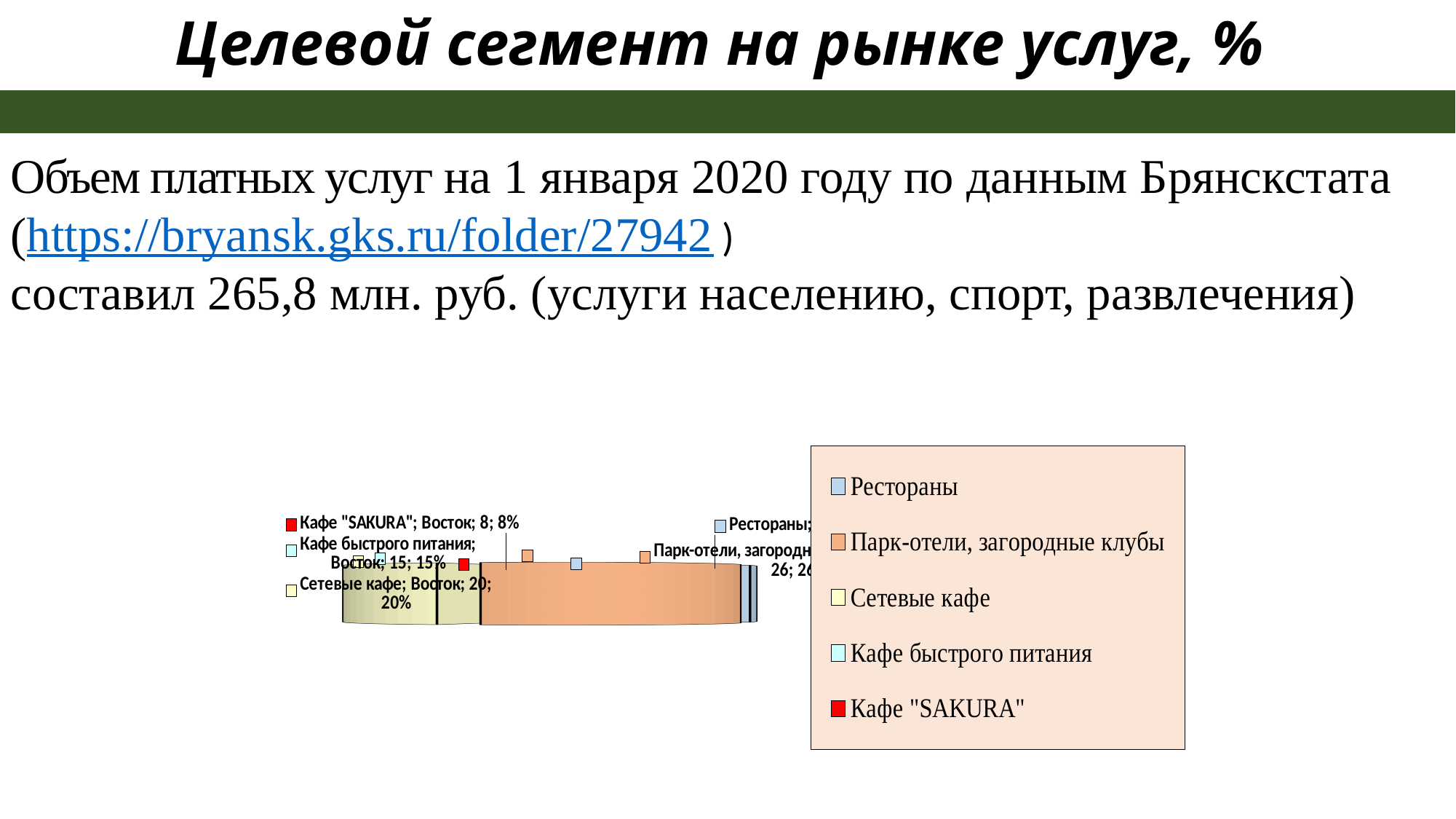
What percentage share does Сетевые кафе have in the chart? 20% What is the difference in percentage points between the shares of Сетевые кафе and Кафе быстрого питания? 5 What percentage share does Кафе быстрого питания have in the chart? 15% What percentage share does Кафе "SAKURA" have in the chart? 8% Which has the larger share: Кафе "SAKURA" or Кафе быстрого питания? Кафе быстрого питания What is the difference in percentage points between the shares of Сетевые кафе and Кафе "SAKURA"? 12 What is the title of the slide containing the chart? Целевой сегмент на рынке услуг, % What value is shown in the data label for Парк-отели, загородные клубы? 26 How many entries does the chart legend list? 5 Which has the larger share: Сетевые кафе or Кафе быстрого питания? Сетевые кафе What kind of chart is shown on the slide? pie chart What colour is used for Кафе "SAKURA" in the legend? red